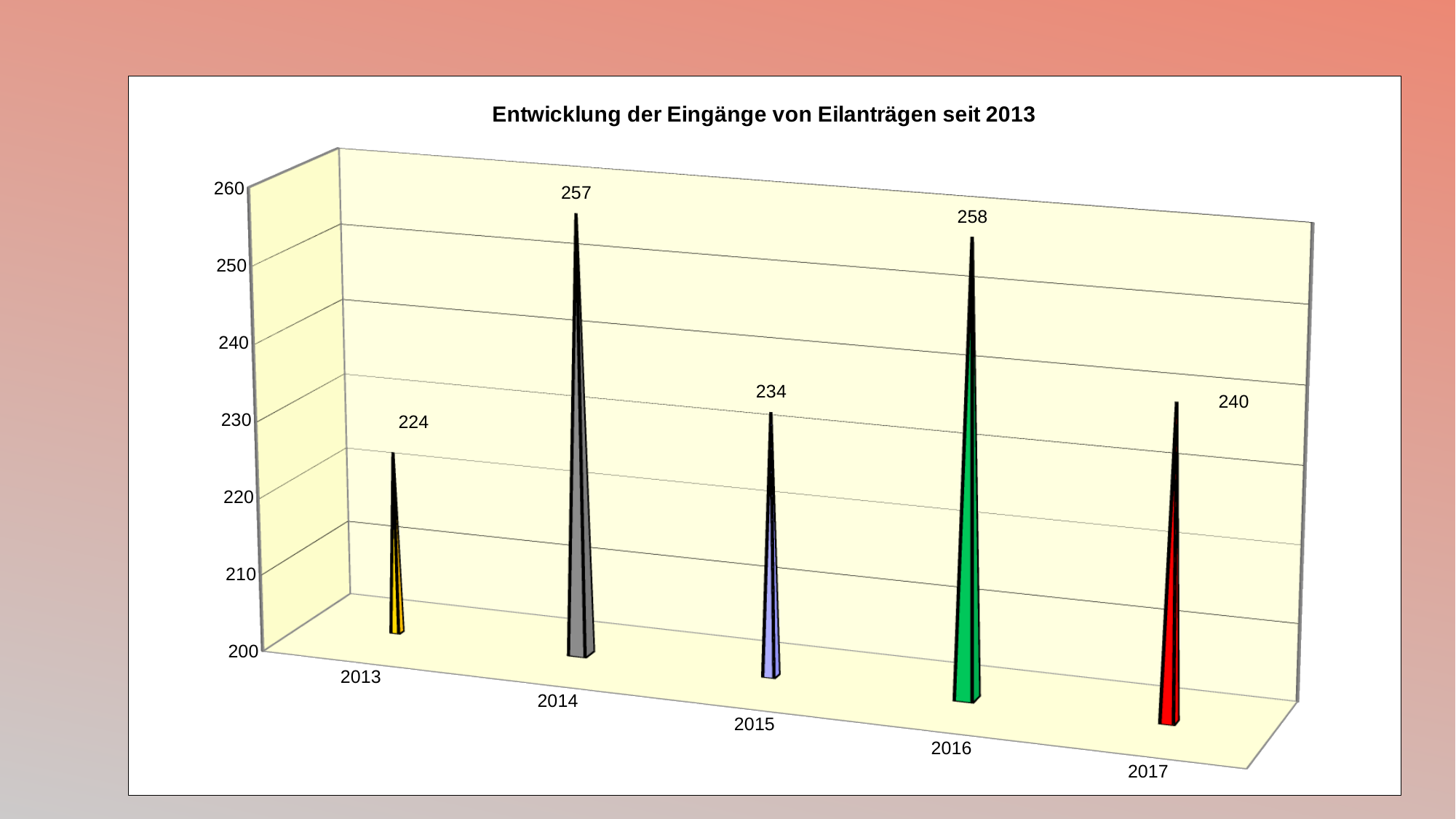
What is the difference between the values for 2016 and 2017? 18 Is the value for 2014 greater or less than 250? greater What kind of chart is shown? bar chart What is the value for 2013? 224 How many years are shown on the x axis? 5 What is the value for 2017? 240 Which year has the highest value? 2016 What is the title of the chart? Entwicklung der Eingänge von Eilanträgen seit 2013 Which is larger, the value for 2015 or the value for 2017? 2017 What is the difference between the values for 2014 and 2013? 33 What is the value for 2015? 234 Which year has the lowest value? 2013